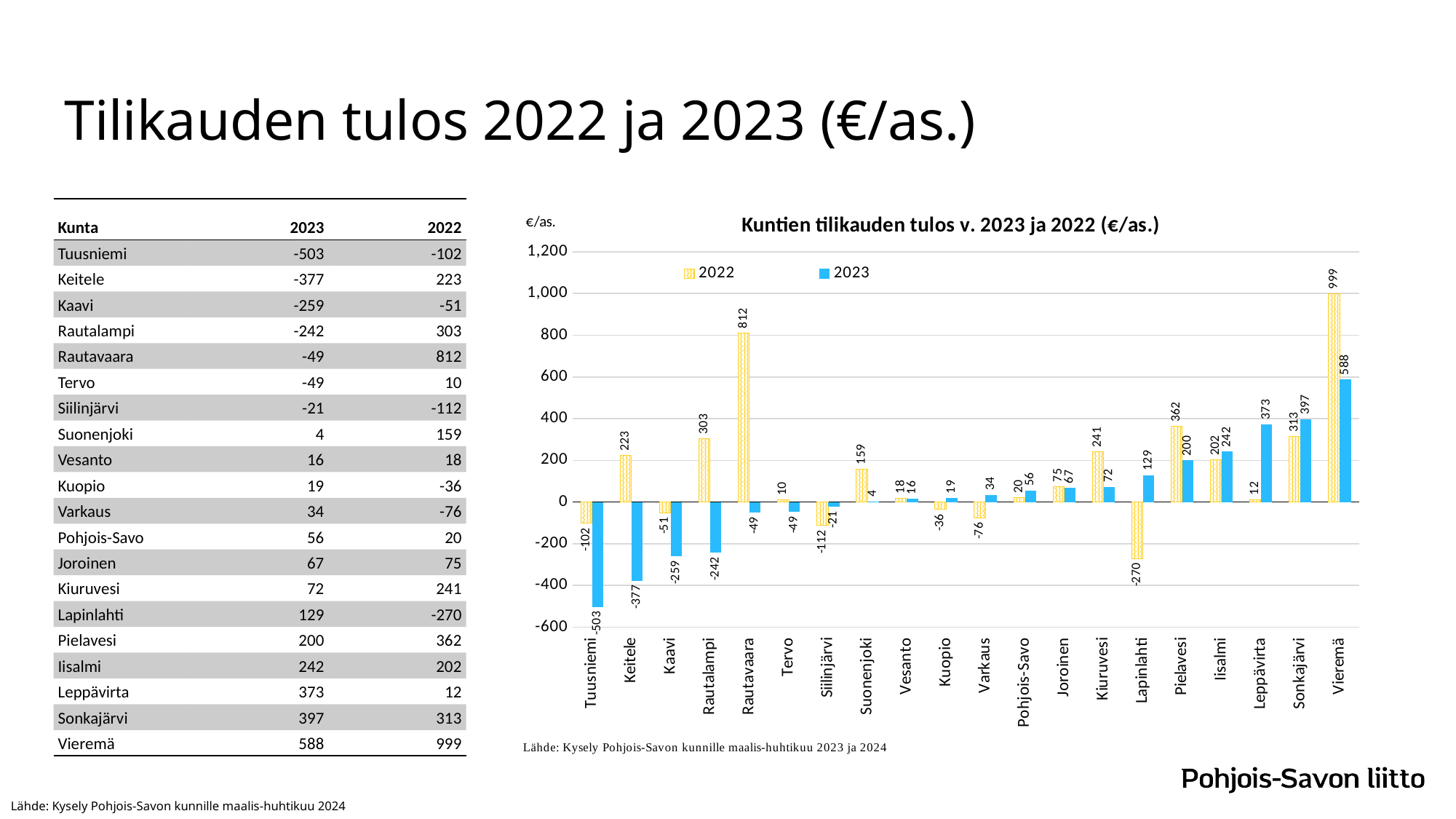
What is the 2023 value for Lapinlahti in the chart? 129 What is the title of the chart? Kuntien tilikauden tulos v. 2023 ja 2022 (€/as.) What is the 2023 value for Tuusniemi in the chart? -503 How many series does the chart legend list? 2 For Leppävirta, which is larger: the 2022 value or the 2023 value? 2023 What is the 2022 value for Rautavaara in the chart? 812 Which municipality has the lowest 2023 value in the chart? Tuusniemi What kind of chart is shown on the slide? bar chart Which municipality has the highest 2022 value in the chart? Vieremä Which colour represents the 2023 series in the chart? blue How many municipalities are shown on the x axis of the chart? 20 What is the difference between the 2022 and 2023 values for Vieremä? 411